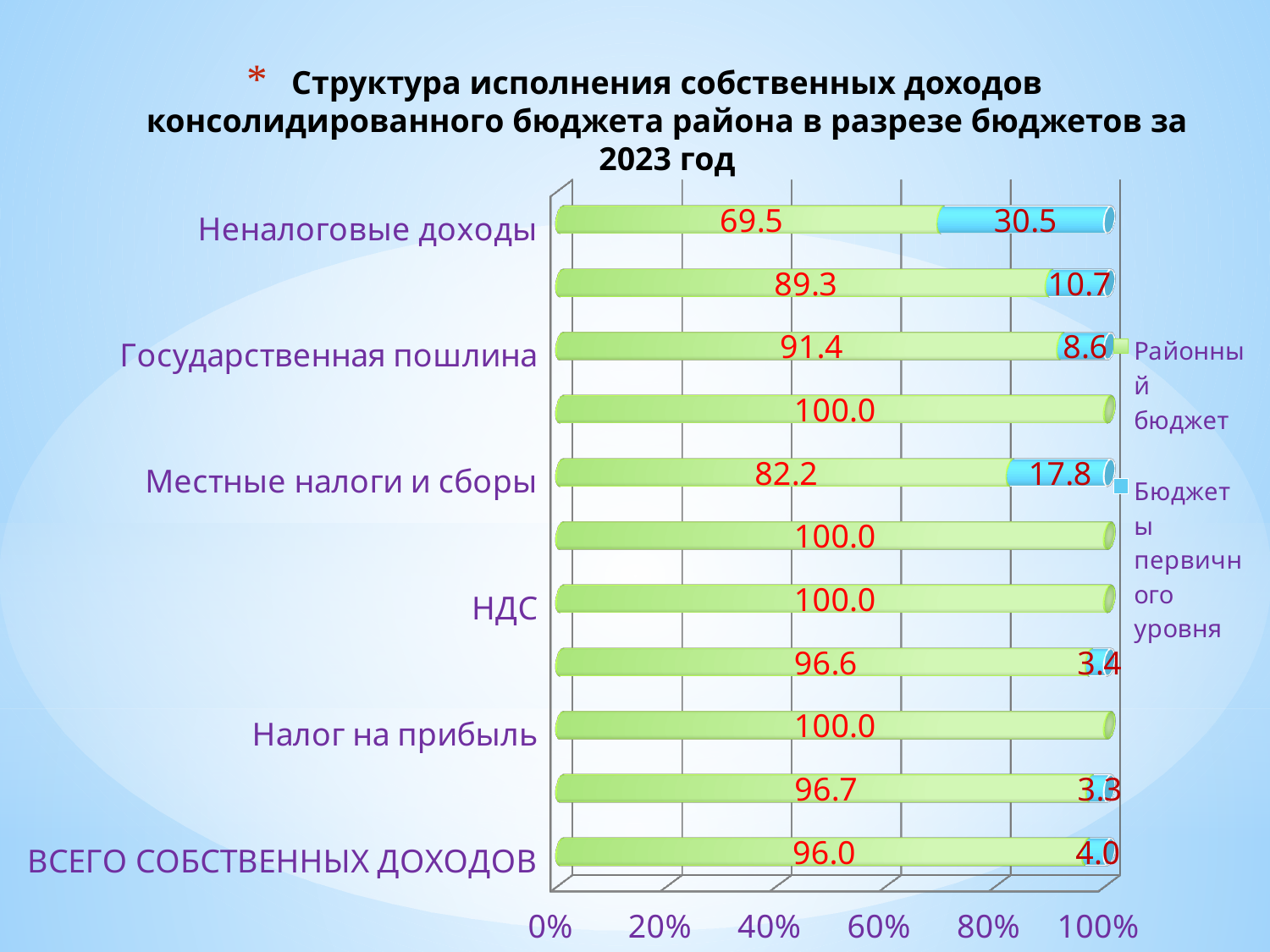
What kind of chart is shown on the slide? Stacked bar chart Which has a larger Бюджеты первичного уровня value: Неналоговые доходы or Местные налоги и сборы? Неналоговые доходы What is the difference between the Районный бюджет values for Государственная пошлина and Местные налоги и сборы? 9.2 How many bars are plotted in the chart? 11 Which colour represents Районный бюджет in the chart? Green What is the value of Районный бюджет for НДС? 100.0 What is the value of Районный бюджет for Государственная пошлина? 91.4 What is the value of Бюджеты первичного уровня for Неналоговые доходы? 30.5 What is the value of Бюджеты первичного уровня for Местные налоги и сборы? 17.8 How many series does the legend list? 2 What is the value of Бюджеты первичного уровня for ВСЕГО СОБСТВЕННЫХ ДОХОДОВ? 4.0 What is the value of Районный бюджет for Неналоговые доходы? 69.5